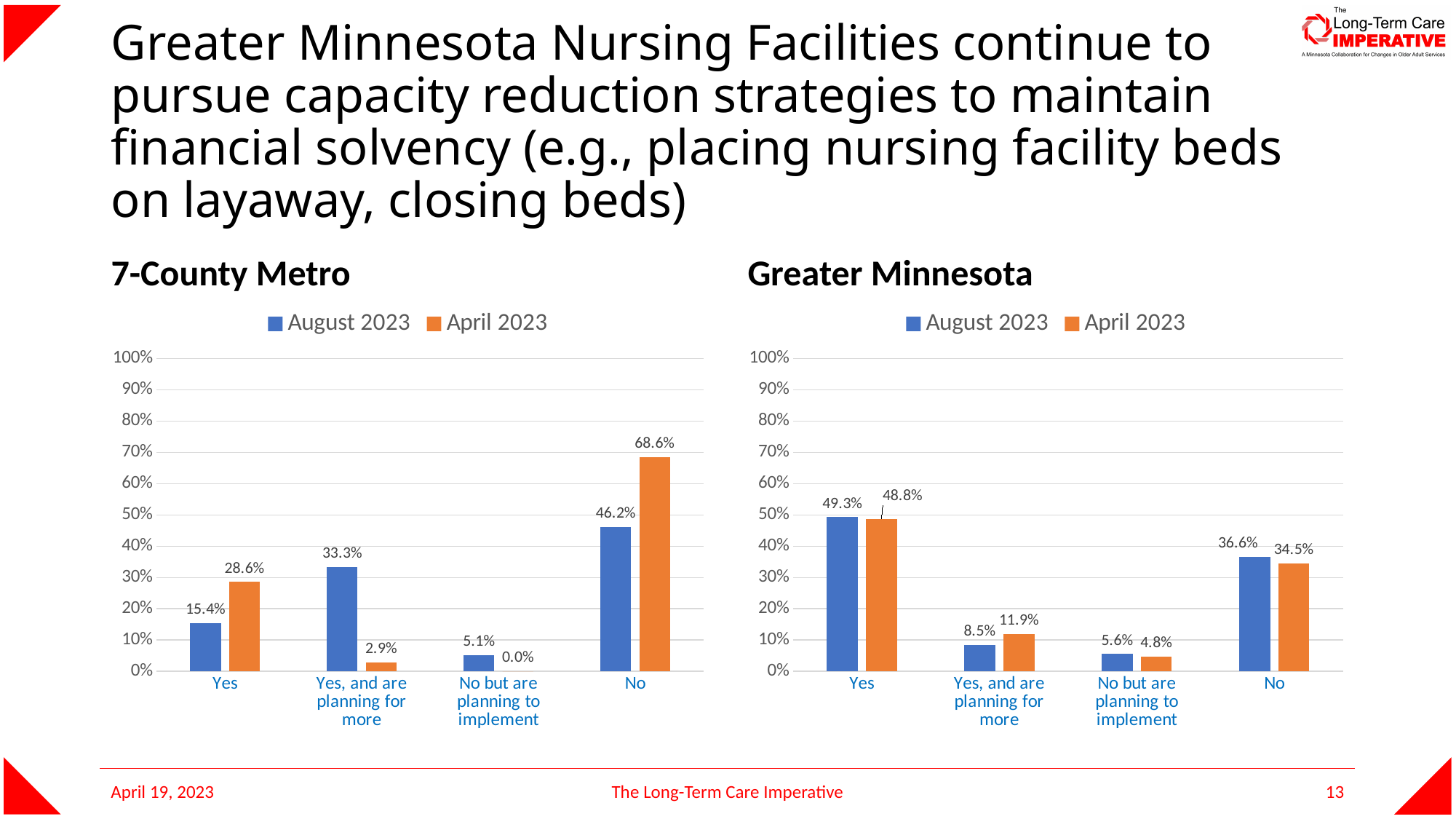
In the 7-County Metro chart, is the April 2023 value for "No" greater or less than 60%? greater In the Greater Minnesota chart, which category has the lowest August 2023 value? No but are planning to implement In the Greater Minnesota chart, what is the April 2023 value for "No but are planning to implement"? 4.8% In the 7-County Metro chart, what is the difference between the April 2023 and August 2023 values for "No"? 22.4% In the 7-County Metro chart, what is the April 2023 value for "Yes, and are planning for more"? 2.9% In the Greater Minnesota chart, what is the August 2023 value for "Yes"? 49.3% How many categories are shown on the x axis of the Greater Minnesota chart? 4 How many series does the legend of the 7-County Metro chart list? 2 What kind of chart is the Greater Minnesota chart? Bar chart In the Greater Minnesota chart, which is larger for "Yes, and are planning for more": August 2023 or April 2023? April 2023 In the 7-County Metro chart, which category has the highest April 2023 value? No In the 7-County Metro chart, what is the August 2023 value for "No"? 46.2%